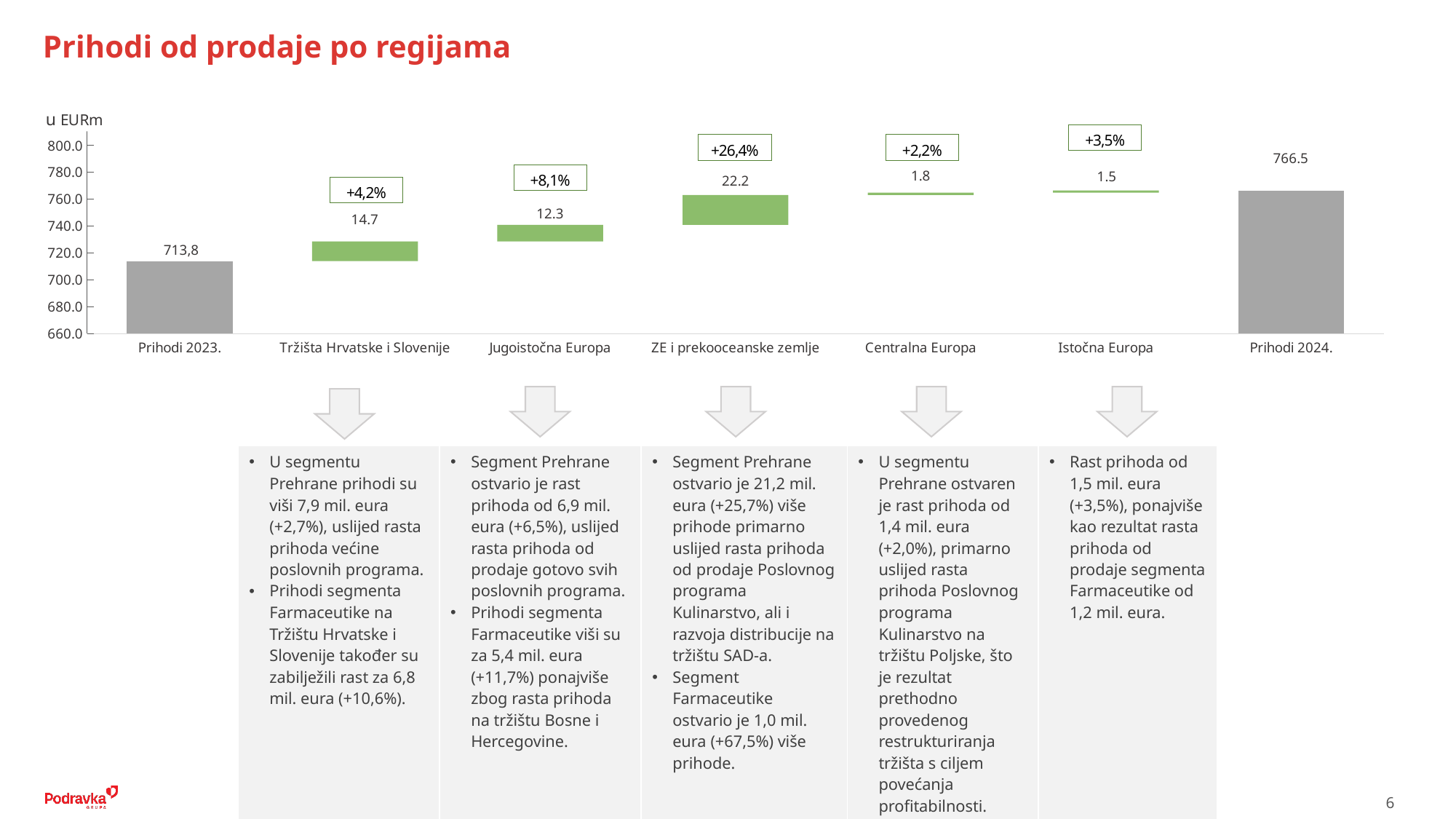
What is the increase shown for ZE i prekooceanske zemlje? 22.2 Which is larger, the increase for Tržišta Hrvatske i Slovenije or for Jugoistočna Europa? Tržišta Hrvatske i Slovenije What is the value shown for Prihodi 2023.? 713,8 What is the value shown for Prihodi 2024.? 766.5 What unit is the chart expressed in, according to the label above the axis? u EURm What is the difference between the increases for ZE i prekooceanske zemlje and Jugoistočna Europa? 9.9 Which region contributed the smallest increase in revenue? Istočna Europa What percentage change is shown for Centralna Europa? +2,2% What percentage change is shown for Jugoistočna Europa? +8,1% How many categories are shown on the x axis of the chart? 7 Which region contributed the largest increase in revenue? ZE i prekooceanske zemlje What is the difference between Prihodi 2024. and Prihodi 2023.? 52.7